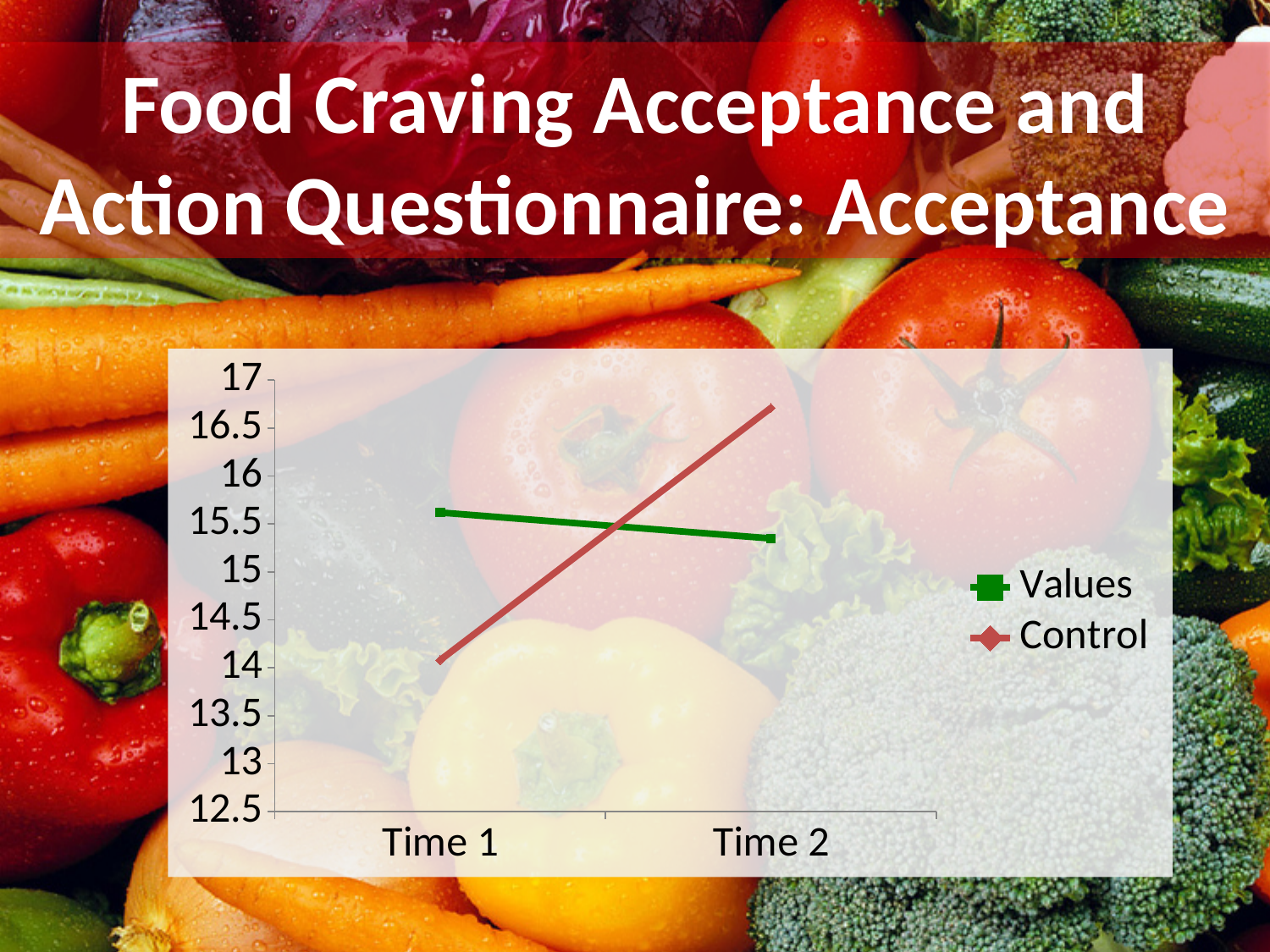
Does the Values series rise or fall from Time 1 to Time 2? fall How many time points are shown on the x axis? 2 At Time 2, which series has the higher value, Values or Control? Control Is the value for Values at Time 1 greater or less than 15? greater Is the value for Control at Time 1 greater or less than 14.5? less Does the Control series rise or fall from Time 1 to Time 2? rise Is the value for Values at Time 2 greater or less than 15.5? less At Time 1, which series has the higher value, Values or Control? Values What kind of chart is shown on the slide? line chart What colour is the Control line in the chart? red How many series does the legend list? 2